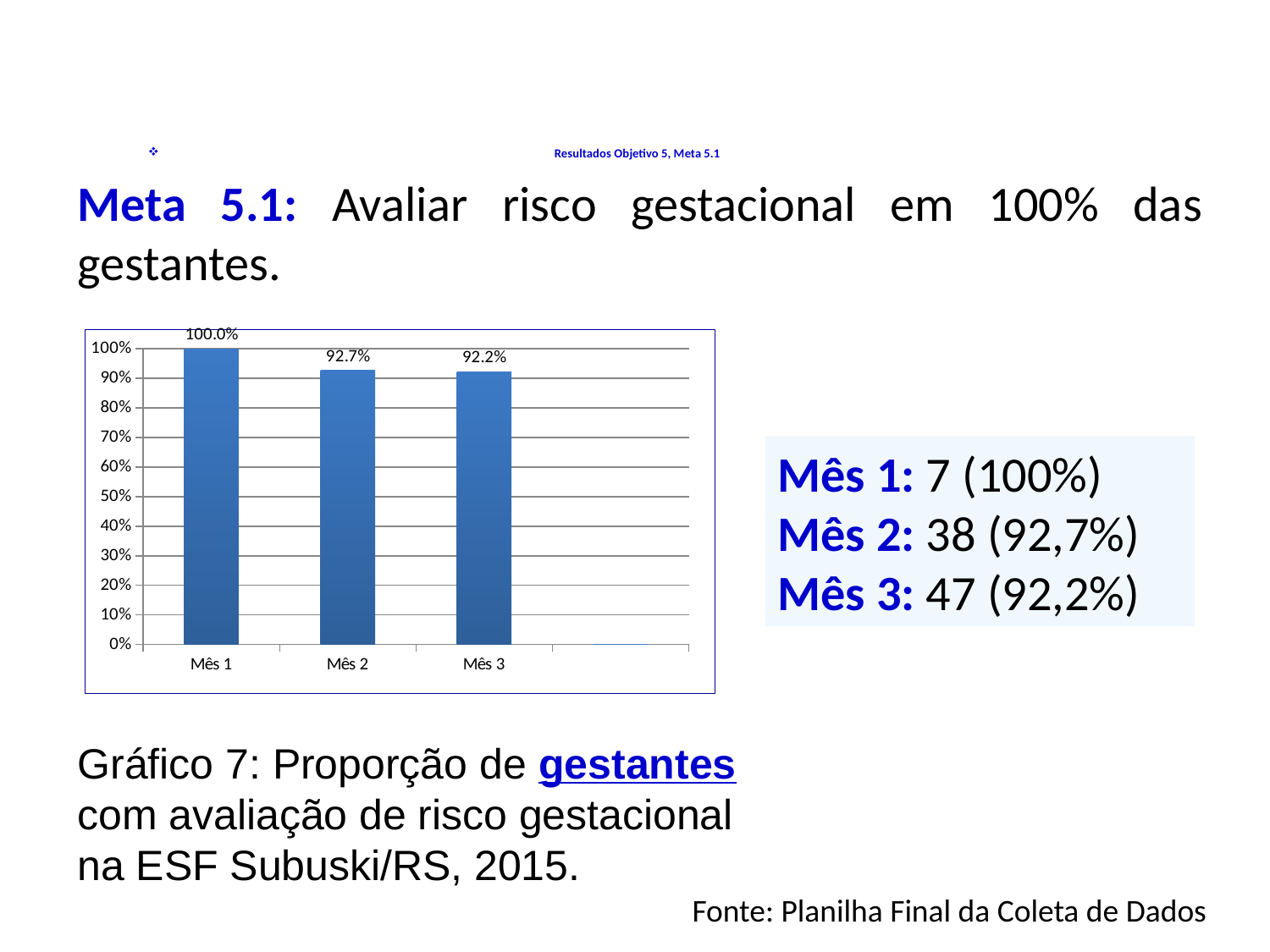
What is the difference between the values for Mês 2 and Mês 3? 0.5% What is the value for Mês 3? 92.2% Is the value for Mês 2 greater or less than 90%? greater What is the value for Mês 1? 100.0% What kind of chart is shown on the slide? bar chart Which month has the lowest value? Mês 3 What is the value for Mês 2? 92.7% Do the values rise or fall from Mês 1 to Mês 3? fall Which is larger, the value for Mês 1 or the value for Mês 3? Mês 1 What is the difference between the values for Mês 1 and Mês 2? 7.3% Which month has the highest value? Mês 1 How many months are shown on the x axis? 3